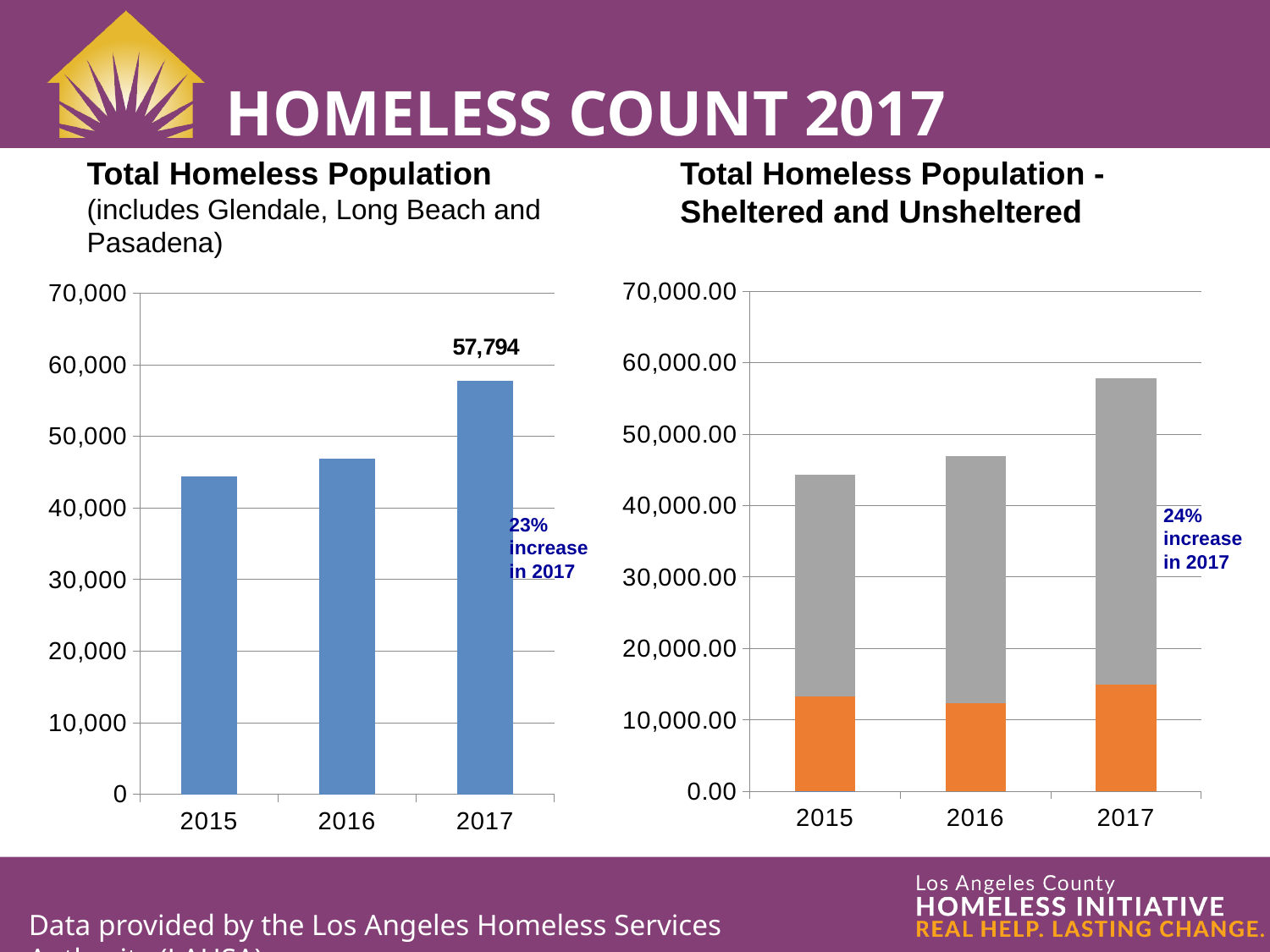
In the left chart, Total Homeless Population, what percentage increase in 2017 is noted next to the 2017 bar? 23% increase in 2017 In the left chart, Total Homeless Population, which year has the lowest value? 2015 In the left chart, Total Homeless Population, what is the value for 2017? 57,794 In the left chart, Total Homeless Population, which year has the highest value? 2017 In the left chart, Total Homeless Population, is the value for 2017 greater or less than 50,000? greater In the right chart, Total Homeless Population - Sheltered and Unsheltered, what percentage increase in 2017 is noted next to the 2017 bar? 24% increase in 2017 In the right chart, Total Homeless Population - Sheltered and Unsheltered, is the total for 2017 greater or less than 50,000.00? greater What kind of chart is the left chart, Total Homeless Population? bar chart In the right chart, Total Homeless Population - Sheltered and Unsheltered, which year has the tallest stacked bar? 2017 In the left chart, Total Homeless Population, do the values rise or fall from 2015 to 2017? rise In the left chart, Total Homeless Population, how many years are shown on the x axis? 3 In the left chart, Total Homeless Population, is the value for 2015 greater or less than 50,000? less